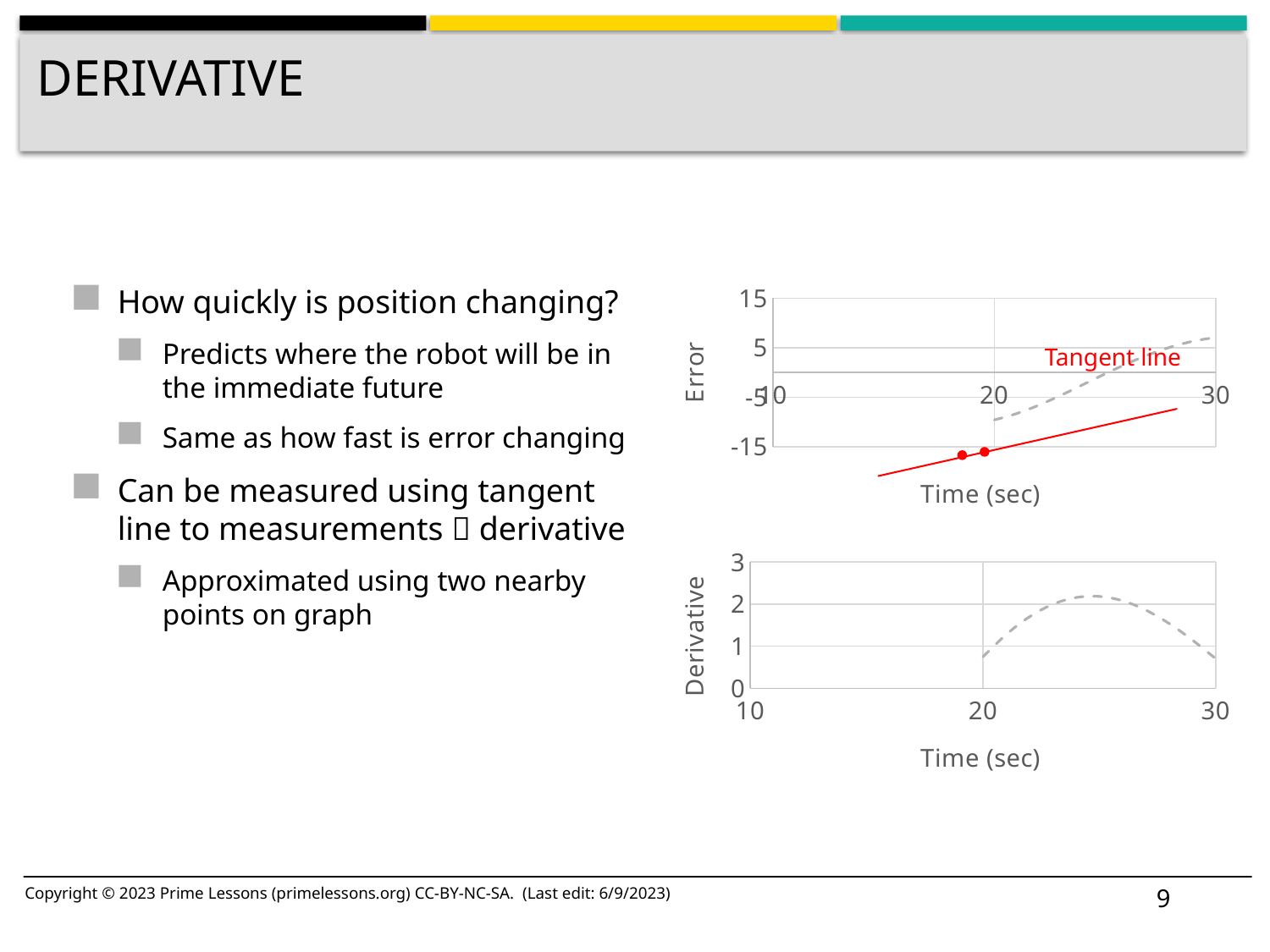
In the bottom chart, is the derivative value at time 25 greater or less than 1? greater In the top chart, is the error value at time 30 greater or less than 5? greater In the bottom chart, is the derivative value at time 20 greater or less than 1? less What kind of chart is the bottom chart on the slide (the one with the Derivative axis)? line chart In the bottom chart, does the derivative curve rise or fall as time goes from 25 to 30? fall In the bottom chart, what is the label on the x axis? Time (sec) What kind of chart is the top chart on the slide (the one with the Error axis)? line chart In the top chart, what is the label of the red straight line? Tangent line In the top chart, does the dashed error curve rise or fall as time goes from 20 to 30? rise In the bottom chart, does the derivative curve rise or fall as time goes from 20 to 25? rise